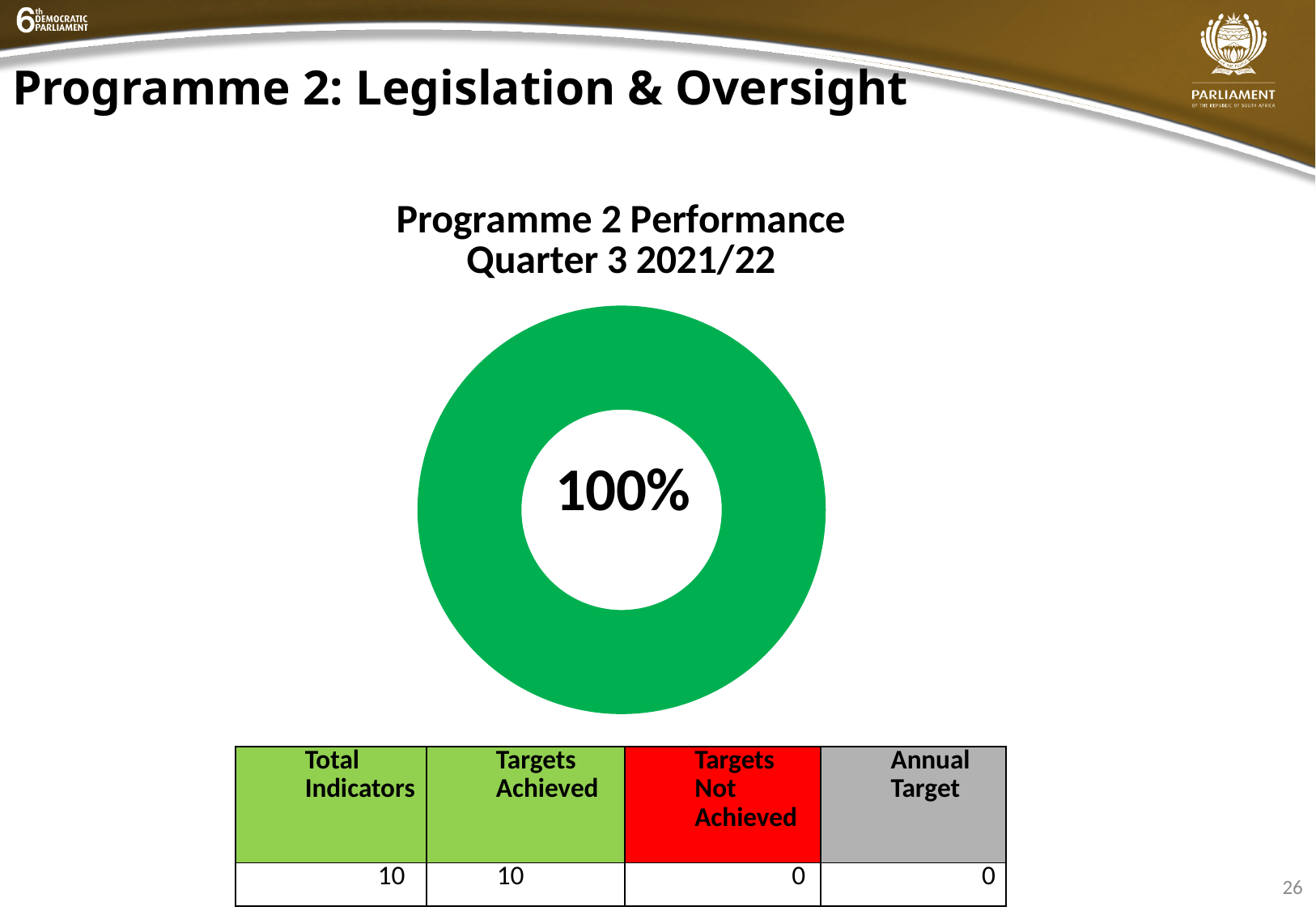
What is the title of the chart? Programme 2 Performance Quarter 3 2021/22 How many visible segments does the doughnut chart have? 1 What percentage is printed in the centre of the doughnut chart? 100% What kind of chart is shown on the slide? doughnut chart Is the value shown in the doughnut chart greater or less than 50%? greater In the table below the chart, which is larger: Targets Achieved or Targets Not Achieved? Targets Achieved According to the table below the chart, how many Targets Achieved are there? 10 In the table below the chart, what is the difference between Total Indicators and Targets Achieved? 0 What colour is the filled segment of the doughnut chart? green According to the table below the chart, how many Targets Not Achieved are there? 0 According to the table below the chart, how many Total Indicators are there? 10 What share of the doughnut chart does the green segment occupy? 100%